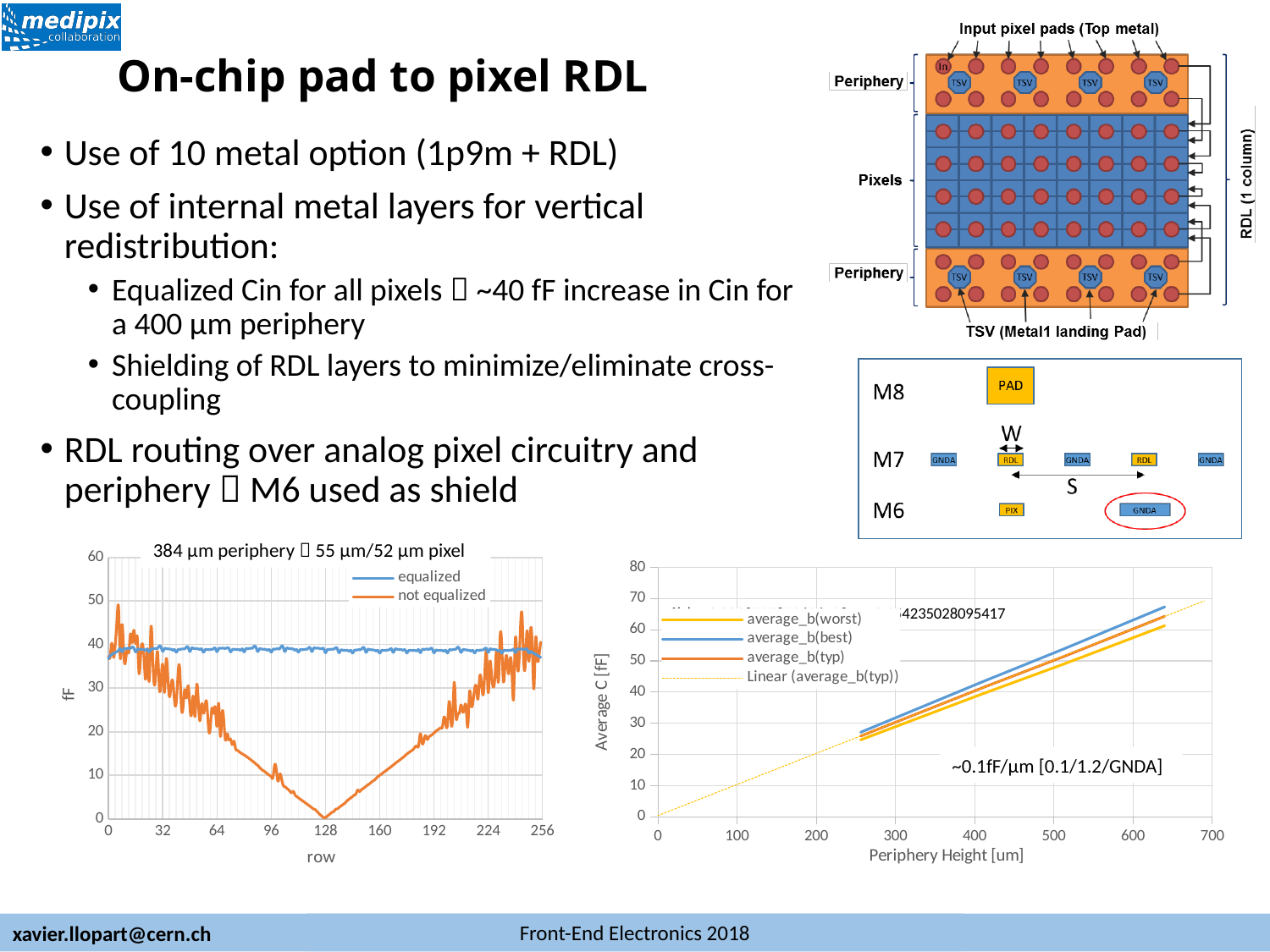
What kind of chart is the chart on the right (Average C vs Periphery Height)? line chart In the right chart, does Average C rise or fall as Periphery Height increases? rise What is the x-axis title of the right chart? Periphery Height [um] In the left chart, is the 'not equalized' value at row 128 greater or less than 10 fF? less In the right chart, is the value of average_b(best) at a periphery height of 500 um greater or less than 40 fF? greater What kind of chart is the chart on the left (384 µm periphery → 55 µm/52 µm pixel)? line chart What are the two legend entries of the left chart? equalized, not equalized How many entries does the legend of the right chart list? 4 In the left chart, at row 128, which series has the larger value, 'equalized' or 'not equalized'? equalized How many series does the legend of the left chart list? 2 In the left chart, is the 'equalized' value at row 128 greater or less than 30 fF? greater In the left chart, does the 'not equalized' series rise or fall as row goes from 0 to 128? fall